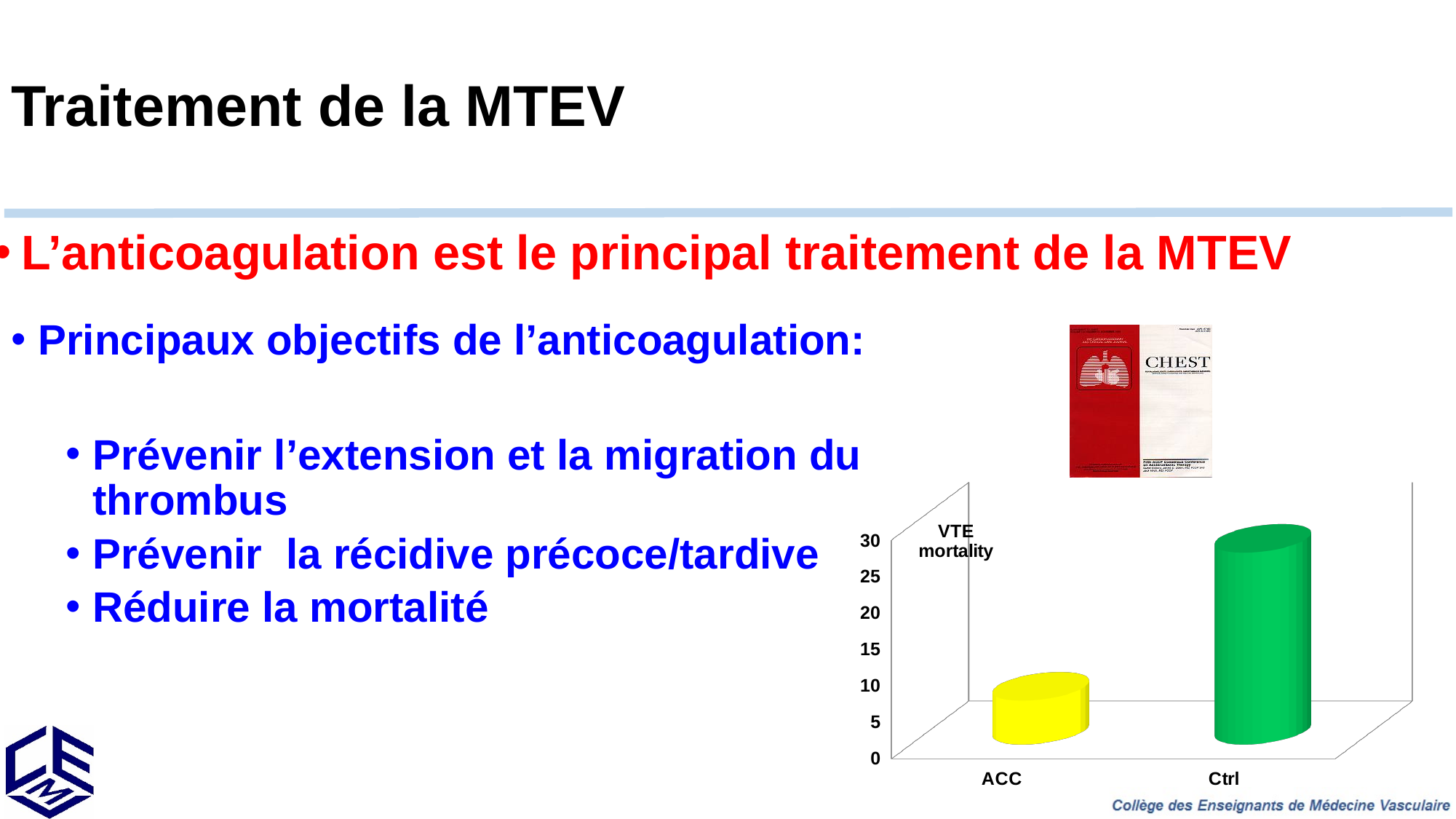
Which is larger in the chart, the value for ACC or the value for Ctrl? Ctrl How many categories are shown on the x axis of the chart? 2 Is the value for Ctrl greater or less than 20? greater What colour is the bar for Ctrl? green Do the values rise or fall going from ACC to Ctrl along the x axis? rise What is the title of the chart? VTE mortality What is the highest value shown on the y axis of the chart? 30 Which category has the lowest VTE mortality in the chart? ACC Which category has the highest VTE mortality in the chart? Ctrl What kind of chart is shown on the slide? bar chart Is the value for Ctrl greater or less than 15? greater